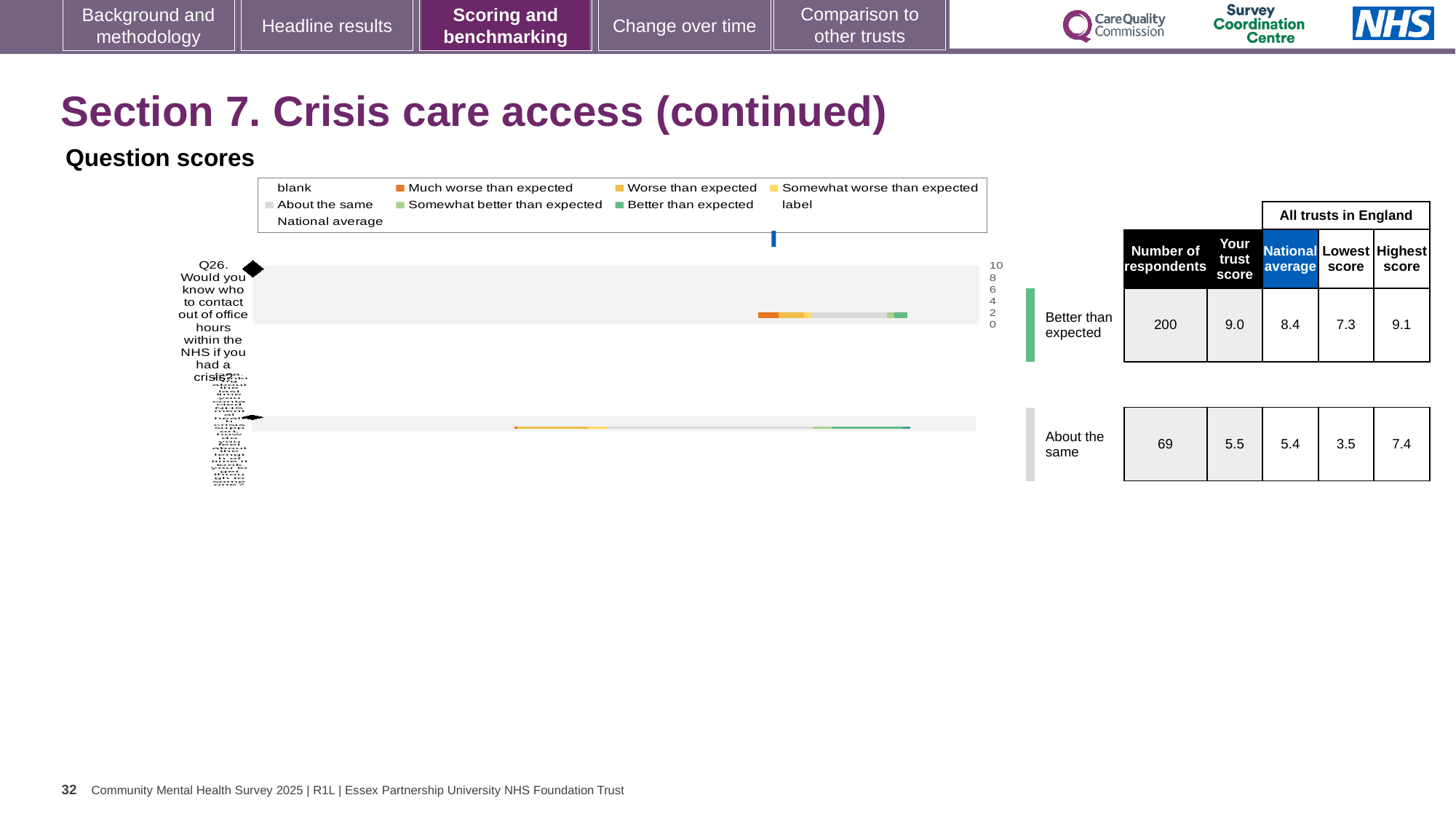
What is the trust score for the question rated 'About the same'? 5.5 What is the difference between the highest and lowest scores for the question rated 'About the same'? 3.9 What is the difference between the trust score and the national average for Q26? 0.6 What benchmark category is Q26 rated as? Better than expected How many question bars are plotted in the chart? 2 Which is larger for Q26, the trust score or the national average? trust score What is the national average for Q26? 8.4 What is the lowest score across all trusts in England for Q26? 7.3 What kind of chart is shown under 'Question scores'? bar chart What is the highest score across all trusts in England for Q26? 9.1 What is the number of respondents for Q26 (Would you know who to contact out of office hours within the NHS if you had a crisis?)? 200 What is the trust score for Q26? 9.0